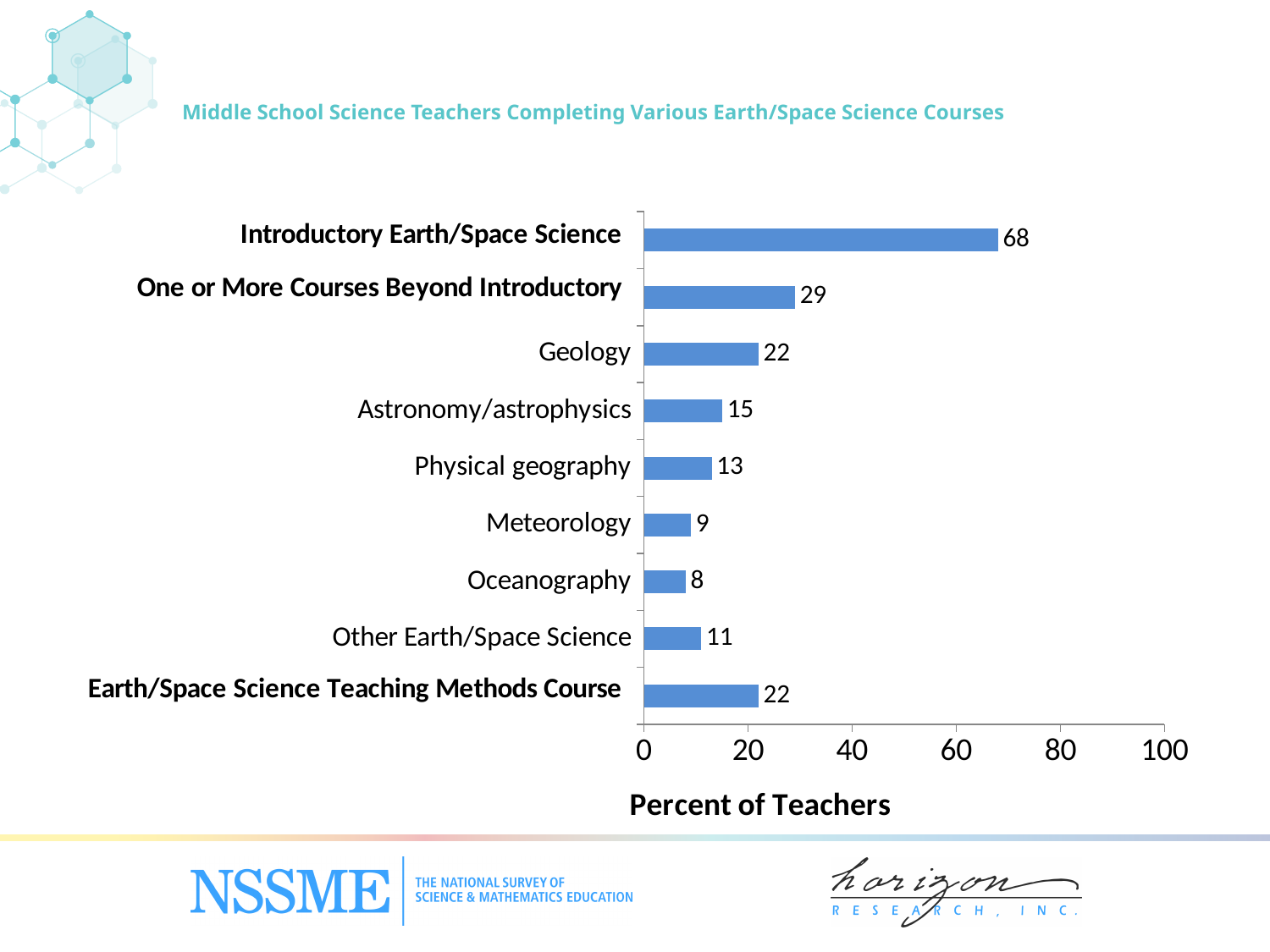
What kind of chart is shown on the slide? bar chart What is the label of the horizontal axis? Percent of Teachers What percent of teachers completed Introductory Earth/Space Science? 68 Is the value for One or More Courses Beyond Introductory greater or less than 20? greater What is the value for Earth/Space Science Teaching Methods Course? 22 Which category has the highest value? Introductory Earth/Space Science What is the value for Oceanography? 8 Which is larger, the value for Astronomy/astrophysics or the value for Physical geography? Astronomy/astrophysics How many categories are shown in the chart? 9 Which category has the lowest value? Oceanography What is the difference between the values for Introductory Earth/Space Science and One or More Courses Beyond Introductory? 39 What is the value for Geology? 22